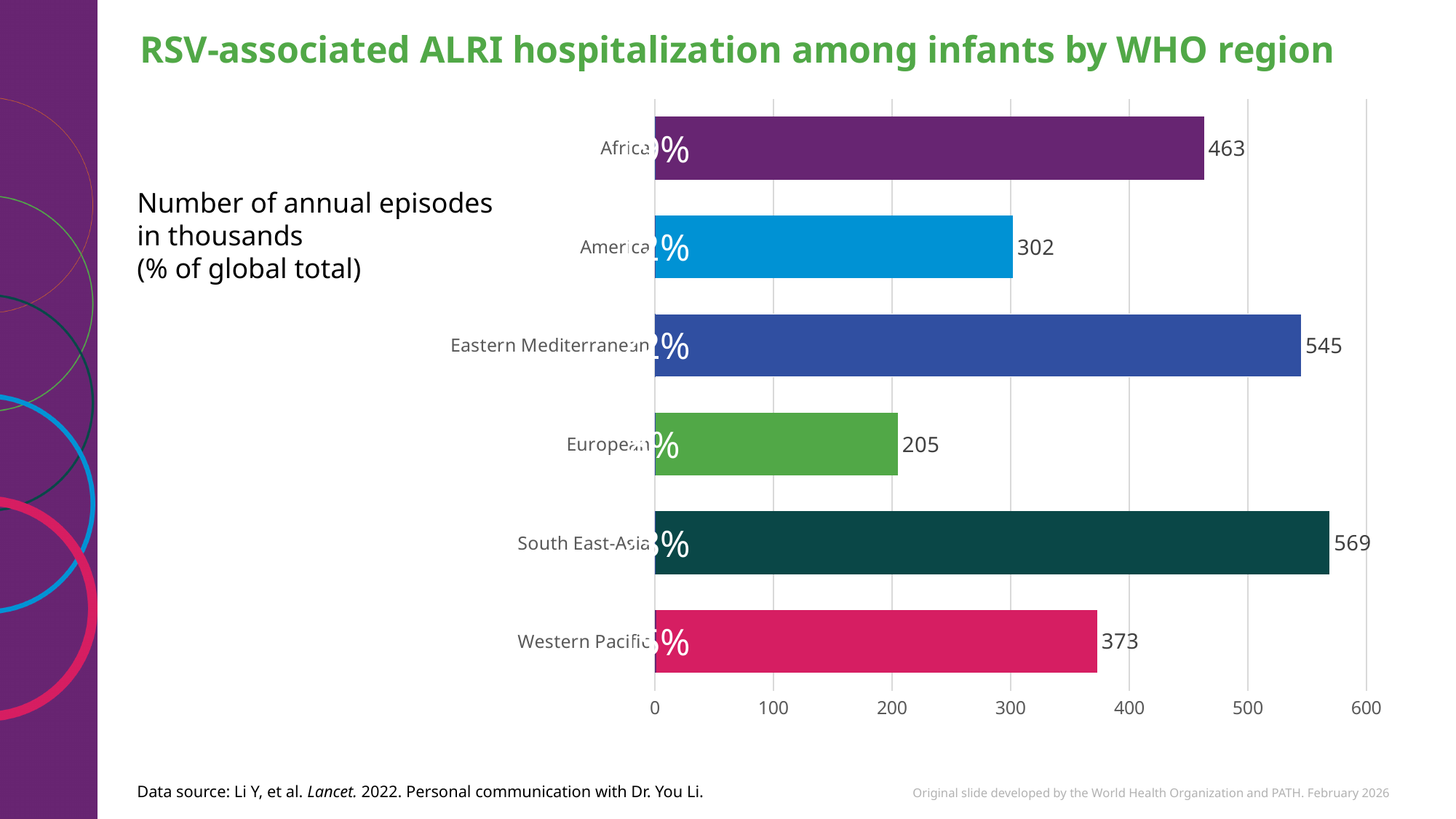
Is the value for Eastern Mediterranean greater or less than 500? greater What is the value shown for the Western Pacific region? 373 Which WHO region has the highest number of annual episodes? South East-Asia What kind of chart is shown on the slide? Bar chart What is the value shown for the Eastern Mediterranean region? 545 What is the number of annual RSV-associated ALRI hospitalization episodes (in thousands) for Africa? 463 What is the value shown for the European region? 205 What is the title of the slide? RSV-associated ALRI hospitalization among infants by WHO region Which WHO region has the lowest number of annual episodes? European Which region has a larger value, America or Western Pacific? Western Pacific What is the difference between the values for South East-Asia and Africa? 106 How many WHO regions are shown in the chart? 6